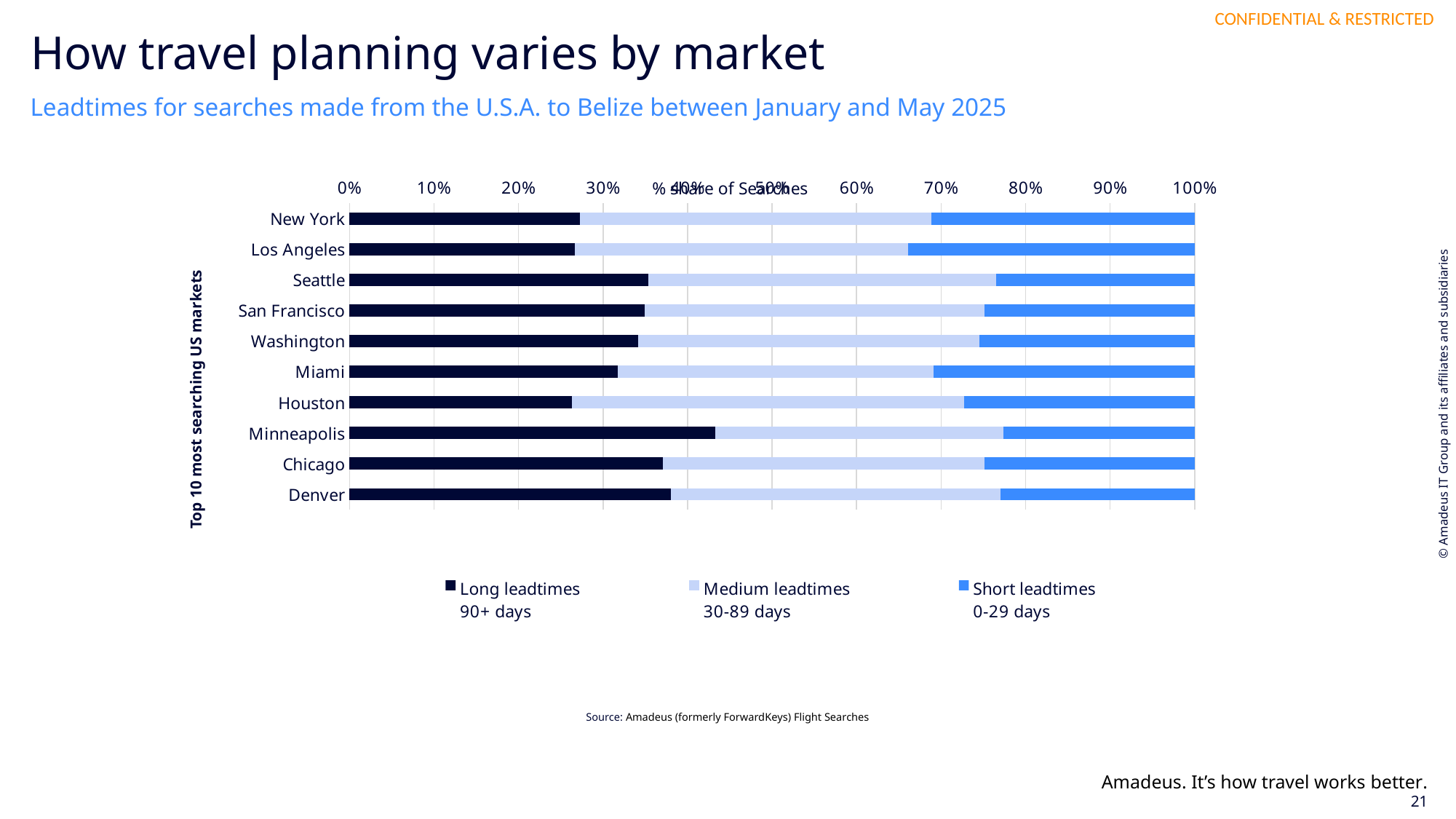
Which market has the largest share of long leadtimes (90+ days)? Minneapolis Is the share of long leadtimes for Minneapolis greater or less than 40%? greater How many US markets are listed on the chart? 10 Is the share of long leadtimes for Denver greater or less than 30%? greater Which has a larger share of long leadtimes, Minneapolis or Houston? Minneapolis What is the label of the vertical axis? Top 10 most searching US markets Is the share of long leadtimes for New York greater or less than 30%? less How many series does the legend list? 3 Which market has the largest share of short leadtimes (0-29 days)? Los Angeles What kind of chart is shown on the slide? Stacked bar chart Which legend entry corresponds to 30-89 days? Medium leadtimes What does each stacked bar total on the x axis? 100%